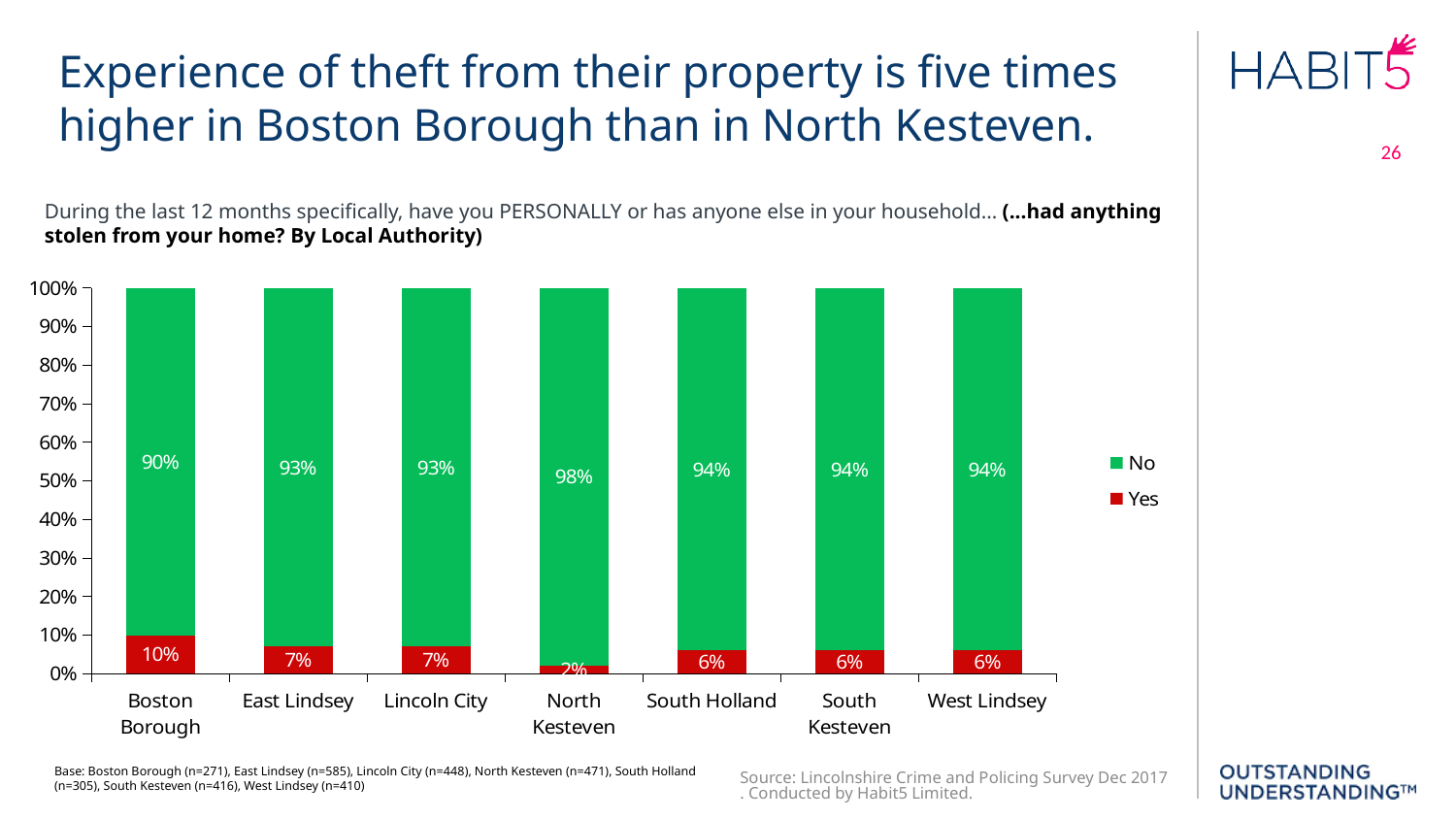
What is the total of the stacked bar for Lincoln City? 100% How many series does the legend list? 2 Which has a higher No percentage, East Lindsey or North Kesteven? North Kesteven How many local authorities are shown on the x axis? 7 What kind of chart is shown on the slide? Stacked bar chart What percentage of North Kesteven respondents answered No? 98% What is the difference between the Yes percentage for Boston Borough and North Kesteven? 8% What percentage of Boston Borough respondents answered Yes? 10% Which local authority has the highest Yes percentage? Boston Borough Which colour represents the Yes series in the legend? Red What is the Yes value for South Holland? 6% Which local authority has the lowest Yes percentage? North Kesteven